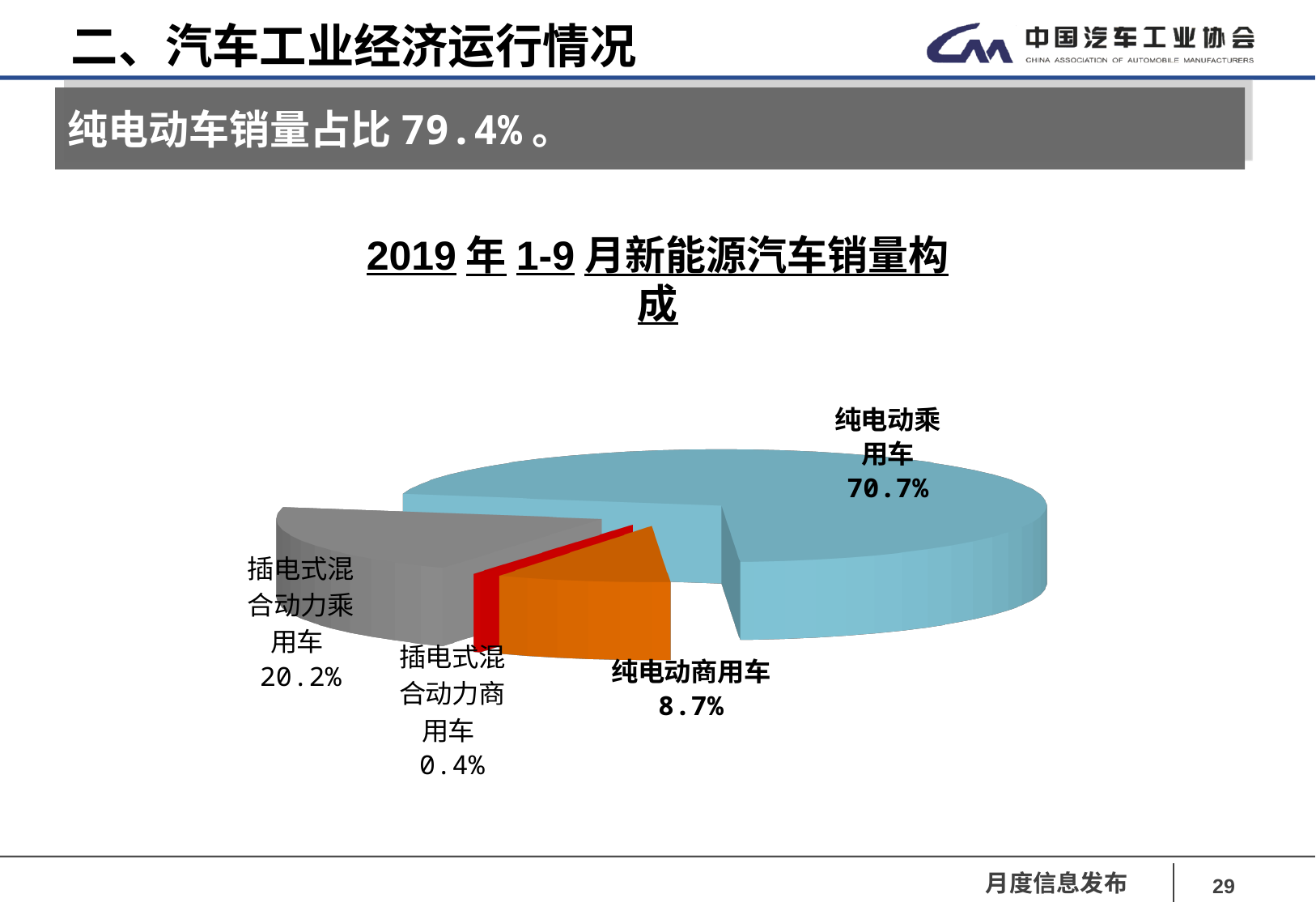
How many categories are shown in the pie chart? 4 Which category has the largest share of the pie? 纯电动乘用车 Which has a larger share, 插电式混合动力乘用车 or 纯电动商用车? 插电式混合动力乘用车 Which category has the smallest share of the pie? 插电式混合动力商用车 What is the difference in share between 纯电动商用车 and 插电式混合动力商用车? 8.3% What kind of chart is shown on the slide? Pie chart What share of the pie does 插电式混合动力商用车 hold? 0.4% What is the title of the chart? 2019年1-9月新能源汽车销量构成 What share of the pie does 插电式混合动力乘用车 hold? 20.2% What share of the pie does 纯电动乘用车 hold? 70.7% What is the difference in share between 纯电动乘用车 and 插电式混合动力乘用车? 50.5%